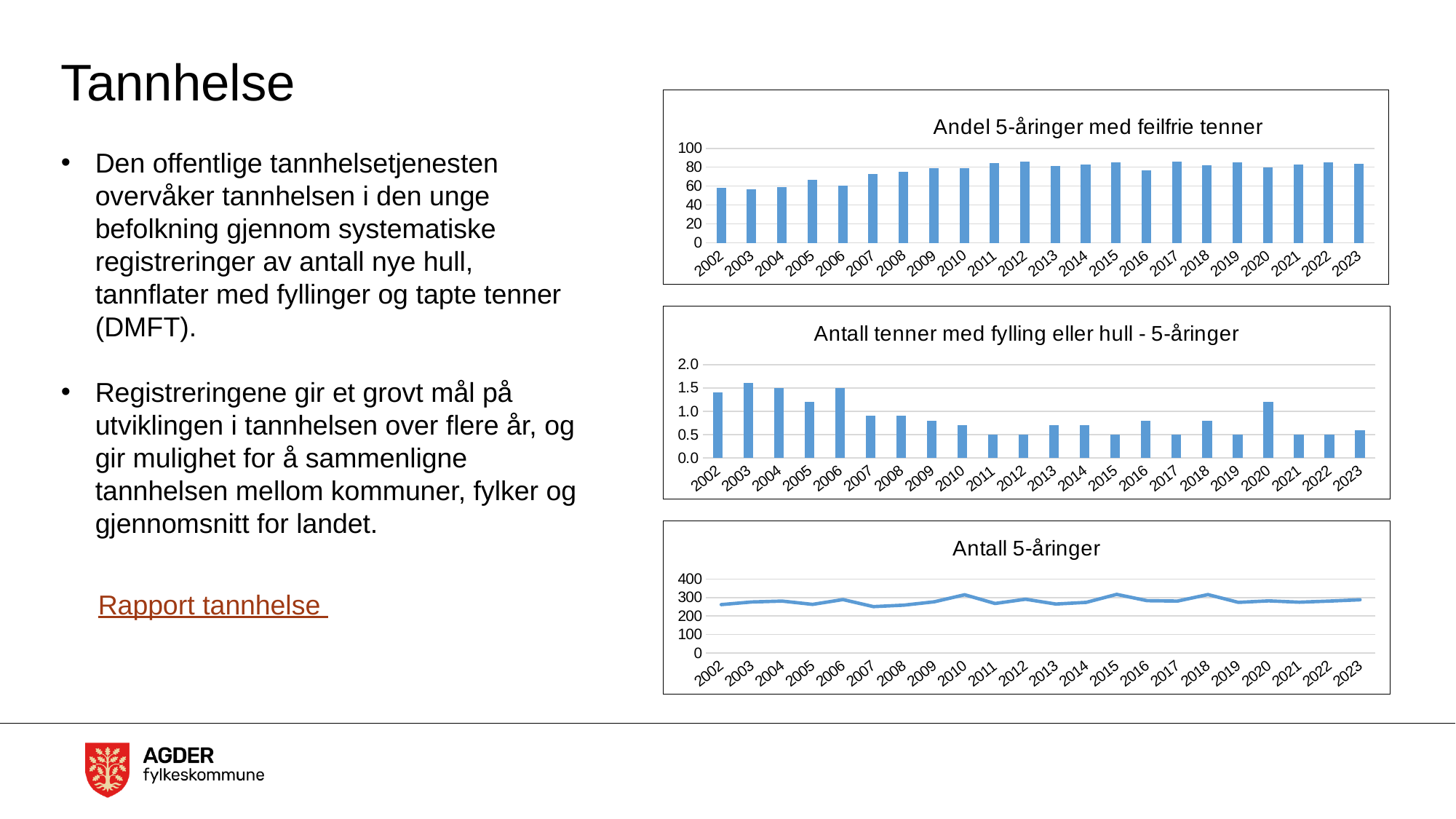
In the middle chart 'Antall tenner med fylling eller hull - 5-åringer', is the value for 2020 greater or less than 1.0? greater In the middle chart 'Antall tenner med fylling eller hull - 5-åringer', do the values generally rise or fall from 2002 to 2023? fall In the middle chart 'Antall tenner med fylling eller hull - 5-åringer', which is larger, the value for 2003 or the value for 2023? 2003 In the top chart 'Andel 5-åringer med feilfrie tenner', is the value for 2005 greater or less than 60? greater In the top chart 'Andel 5-åringer med feilfrie tenner', is the value for 2012 greater or less than 80? greater What kind of chart is the top chart, 'Andel 5-åringer med feilfrie tenner'? bar chart What kind of chart is the bottom chart, 'Antall 5-åringer'? line chart In the middle chart 'Antall tenner med fylling eller hull - 5-åringer', which year has the highest value? 2003 In the top chart 'Andel 5-åringer med feilfrie tenner', do the values generally rise or fall from 2002 to 2023? rise What is the title of the top chart on the slide? Andel 5-åringer med feilfrie tenner In the top chart 'Andel 5-åringer med feilfrie tenner', how many years are shown on the x axis? 22